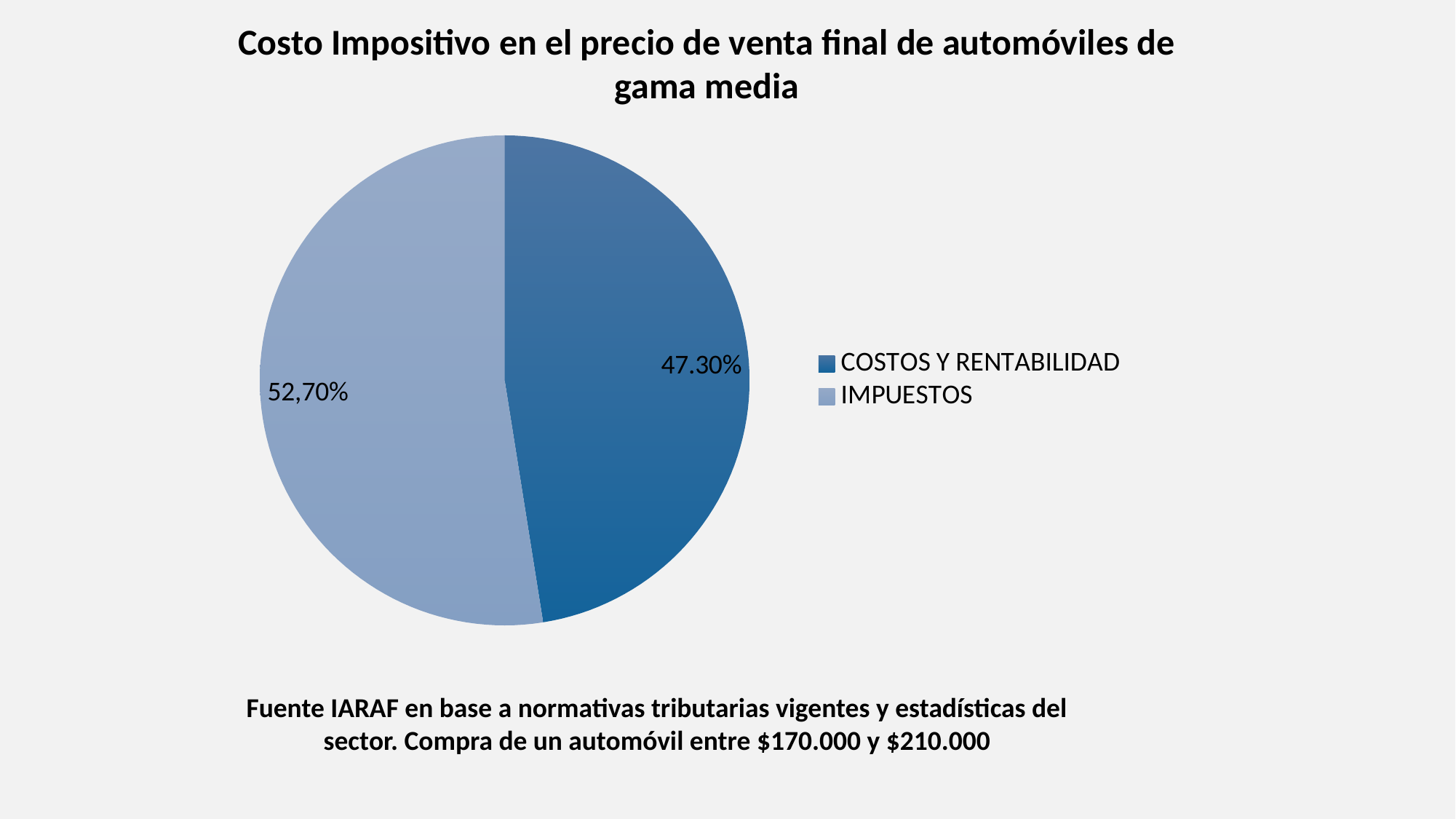
How many slices does the pie chart have? 2 What kind of chart is shown on the slide? Pie chart What is the title of the chart? Costo Impositivo en el precio de venta final de automóviles de gama media What is the value shown for the IMPUESTOS slice? 52,70% Which slice of the pie is the largest? IMPUESTOS Is the share for IMPUESTOS greater or less than 50%? greater What share of the pie does COSTOS Y RENTABILIDAD represent? 47.30% How many entries does the legend list? 2 Which is larger, the IMPUESTOS slice or the COSTOS Y RENTABILIDAD slice? IMPUESTOS Which slice of the pie is the smallest? COSTOS Y RENTABILIDAD What is the value shown for the COSTOS Y RENTABILIDAD slice? 47.30% What share of the pie does IMPUESTOS represent? 52,70%